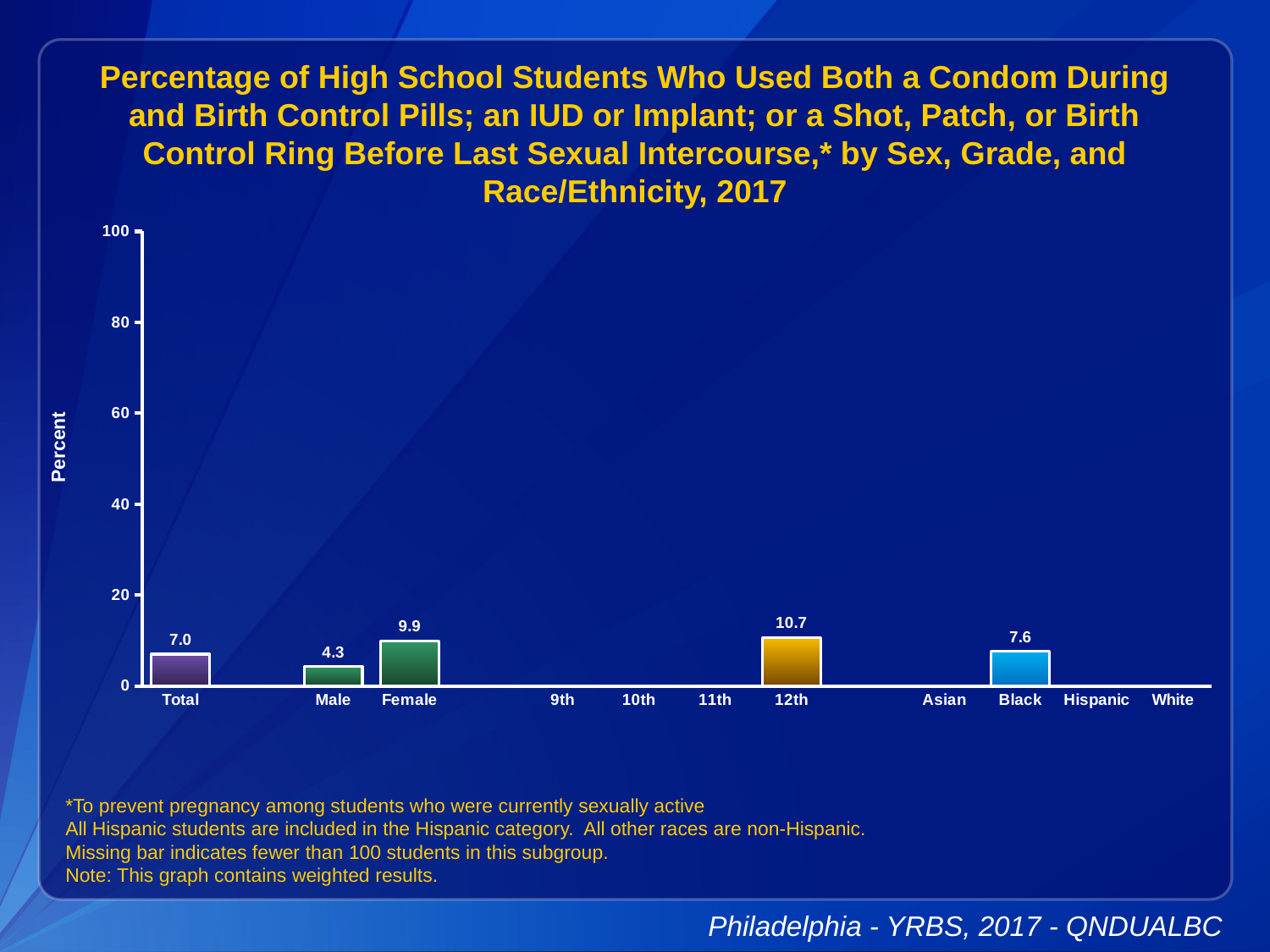
What is the label of the y axis? Percent Is the value for 12th grade greater or less than 20? less What is the value for Black students? 7.6 What is the value for 12th grade? 10.7 What is the value for Female? 9.9 Which is larger, the value for Black or the value for Total? Black What is the difference between the Female and Male values? 5.6 How many bars are plotted on the chart? 5 Which category has the lowest value among the bars shown? Male What kind of chart is this? bar chart What is the value for Total? 7.0 Which category has the highest value? 12th